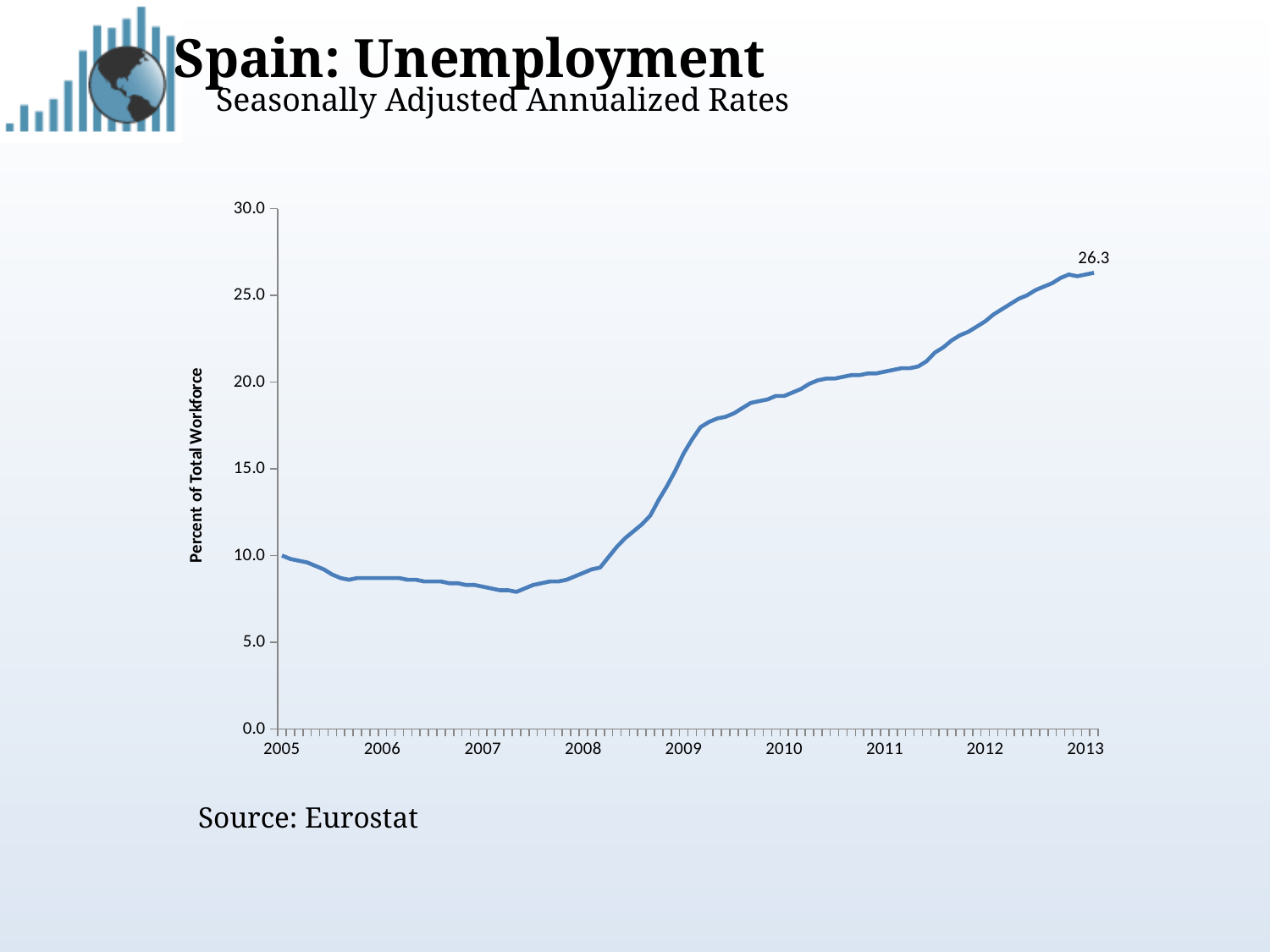
What kind of chart is shown on the slide? line chart In which year does the line reach its highest value? 2013 Is the value for 2012 greater or less than 20.0? greater Is the value for 2010 greater or less than 20.0? less Is the value for 2009 greater or less than 15.0? greater What is the unemployment rate shown by the data label at the end of the line in 2013? 26.3 Which is larger, the value in 2008 or the value in 2011? 2011 What is the source of the data cited on the slide? Eurostat What is the label on the vertical axis? Percent of Total Workforce Overall, does the unemployment rate rise or fall between 2005 and 2013? rise